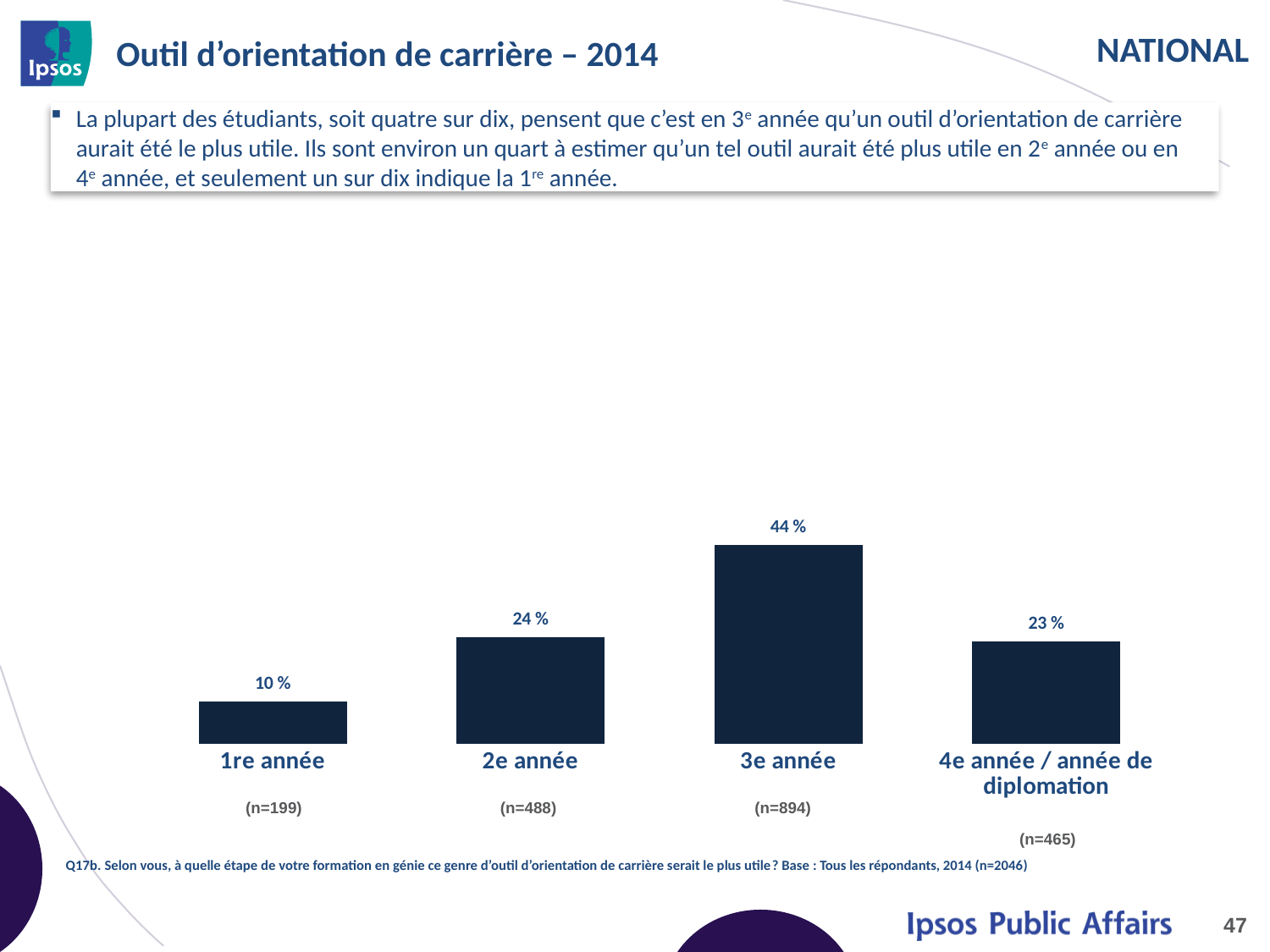
What kind of chart is shown on the slide? bar chart What is the sample size (n) shown under 3e année? (n=894) What is the difference between the values for 2e année and 4e année / année de diplomation? 1 % Which is larger, the value for 3e année or the value for 2e année? 3e année How many categories are shown in the chart? 4 What is the value for 1re année? 10 % What is the value for 4e année / année de diplomation? 23 % Which category has the highest value? 3e année Which category has the lowest value? 1re année What is the difference between the values for 3e année and 1re année? 34 % What is the value for 2e année? 24 % What is the value for 3e année? 44 %